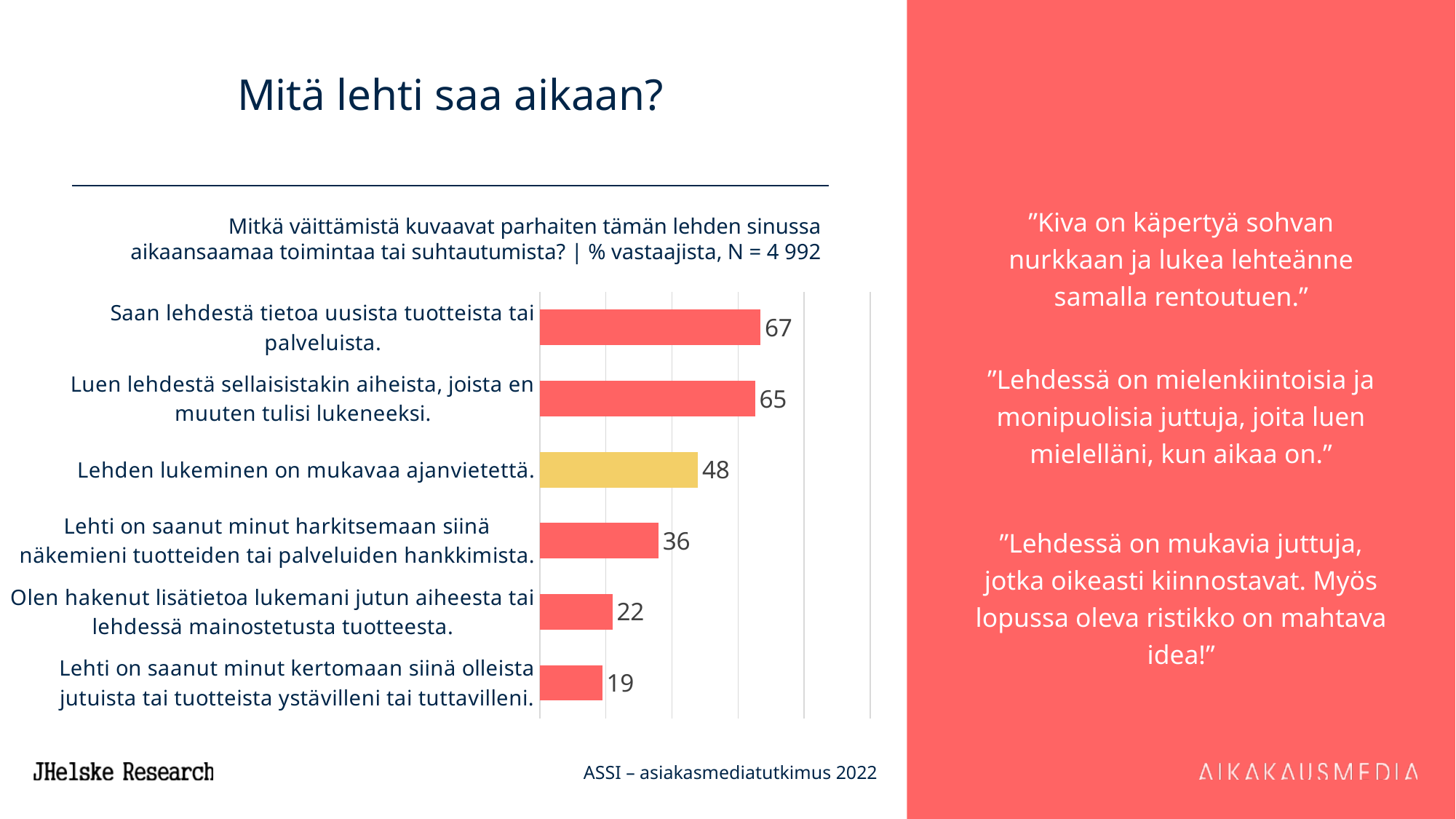
What is the difference between the values for "Luen lehdestä sellaisistakin aiheista, joista en muuten tulisi lukeneeksi." and "Lehti on saanut minut harkitsemaan siinä näkemieni tuotteiden tai palveluiden hankkimista."? 29 What kind of chart is shown on the slide? Bar chart What is the value for "Olen hakenut lisätietoa lukemani jutun aiheesta tai lehdessä mainostetusta tuotteesta."? 22 How many categories are shown in the chart? 6 Which category has the highest value? Saan lehdestä tietoa uusista tuotteista tai palveluista. Which bar is coloured differently (yellow) from the others? Lehden lukeminen on mukavaa ajanvietettä. Which is larger: the value for "Lehden lukeminen on mukavaa ajanvietettä." or the value for "Olen hakenut lisätietoa lukemani jutun aiheesta tai lehdessä mainostetusta tuotteesta."? Lehden lukeminen on mukavaa ajanvietettä. What is the value for "Saan lehdestä tietoa uusista tuotteista tai palveluista."? 67 What is the difference between the highest and lowest values in the chart? 48 Which category has the lowest value? Lehti on saanut minut kertomaan siinä olleista jutuista tai tuotteista ystävilleni tai tuttavilleni. What is the value for "Lehden lukeminen on mukavaa ajanvietettä."? 48 What is the sample size (N) stated in the chart subtitle? N = 4 992